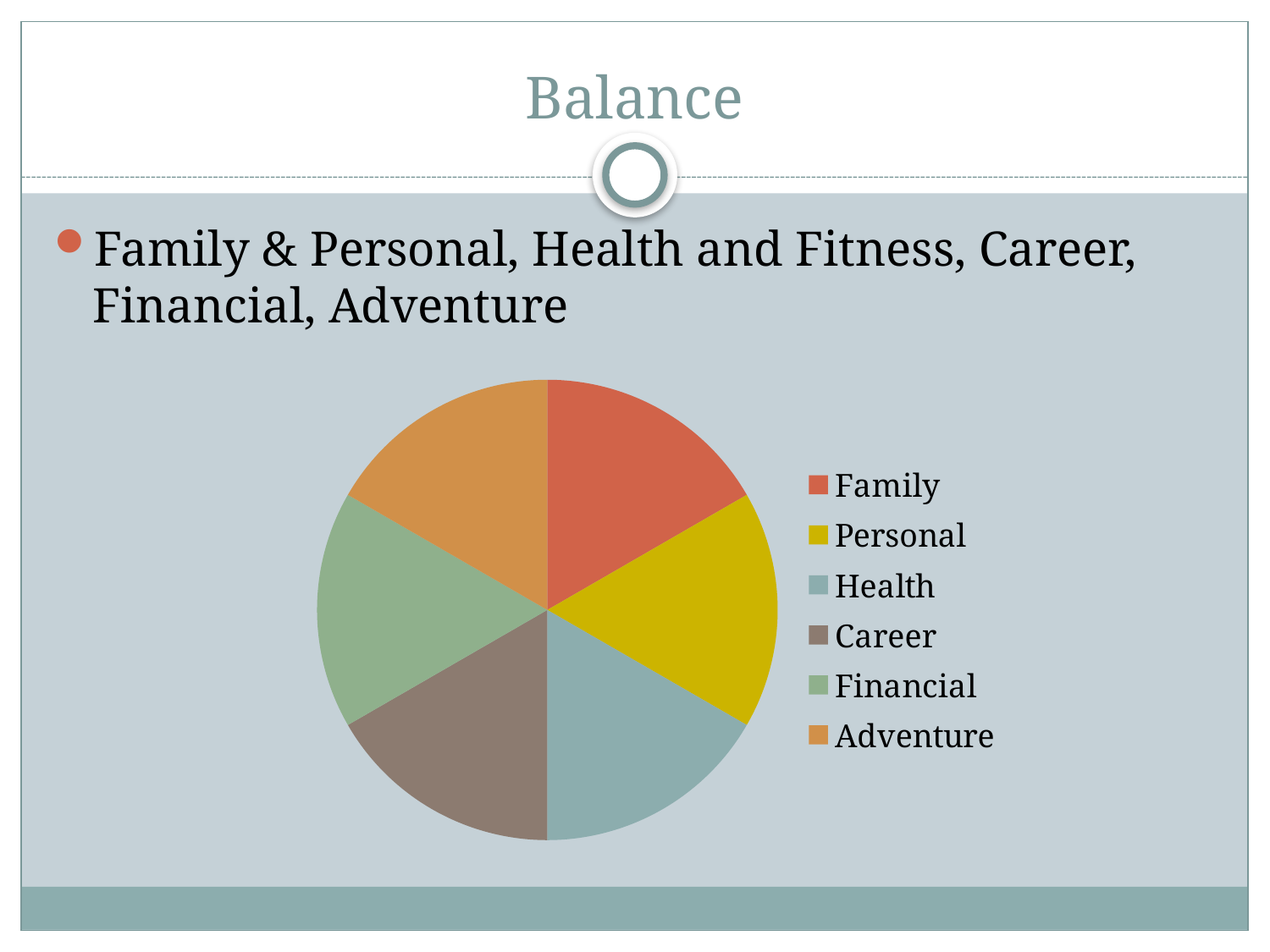
Are the slices of the pie chart roughly equal in size, or does one clearly dominate? Roughly equal How many entries does the legend of the pie chart list? 6 Which category in the pie chart is shown in red? Family Which category is listed first in the legend of the pie chart? Family Which categories are listed in the legend of the pie chart? Family, Personal, Health, Career, Financial, Adventure How many slices does the pie chart have? 6 What kind of chart is shown on the slide? Pie chart